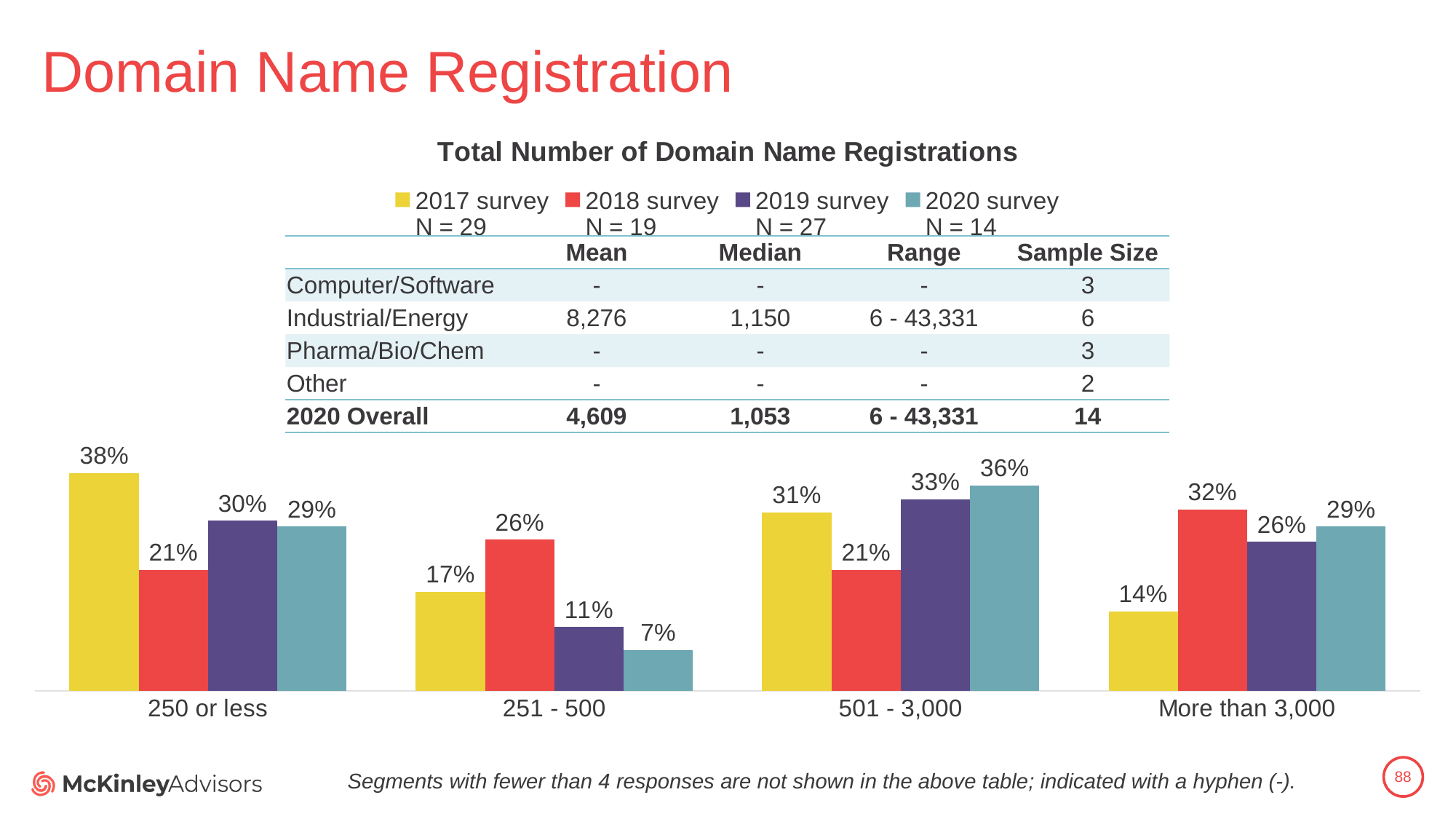
What kind of chart is shown on the slide? Bar chart Do the 2017 survey values rise or fall from "501 - 3,000" to "More than 3,000"? Fall What is the value for the 2020 survey in the "251 - 500" category? 7% What is the sample size (N) for the 2020 survey shown in the legend? N = 14 What is the difference between the 2017 survey and 2018 survey values in the "250 or less" category? 17% How many series does the chart legend list? 4 How many categories are shown on the x axis of the chart? 4 Which is larger in the "251 - 500" category: the 2018 survey value or the 2019 survey value? 2018 survey What is the value for the 2018 survey in the "More than 3,000" category? 32% Which survey year has the highest value in the "501 - 3,000" category? 2020 survey What is the value for the 2017 survey in the "250 or less" category? 38% Which survey year has the lowest value in the "More than 3,000" category? 2017 survey